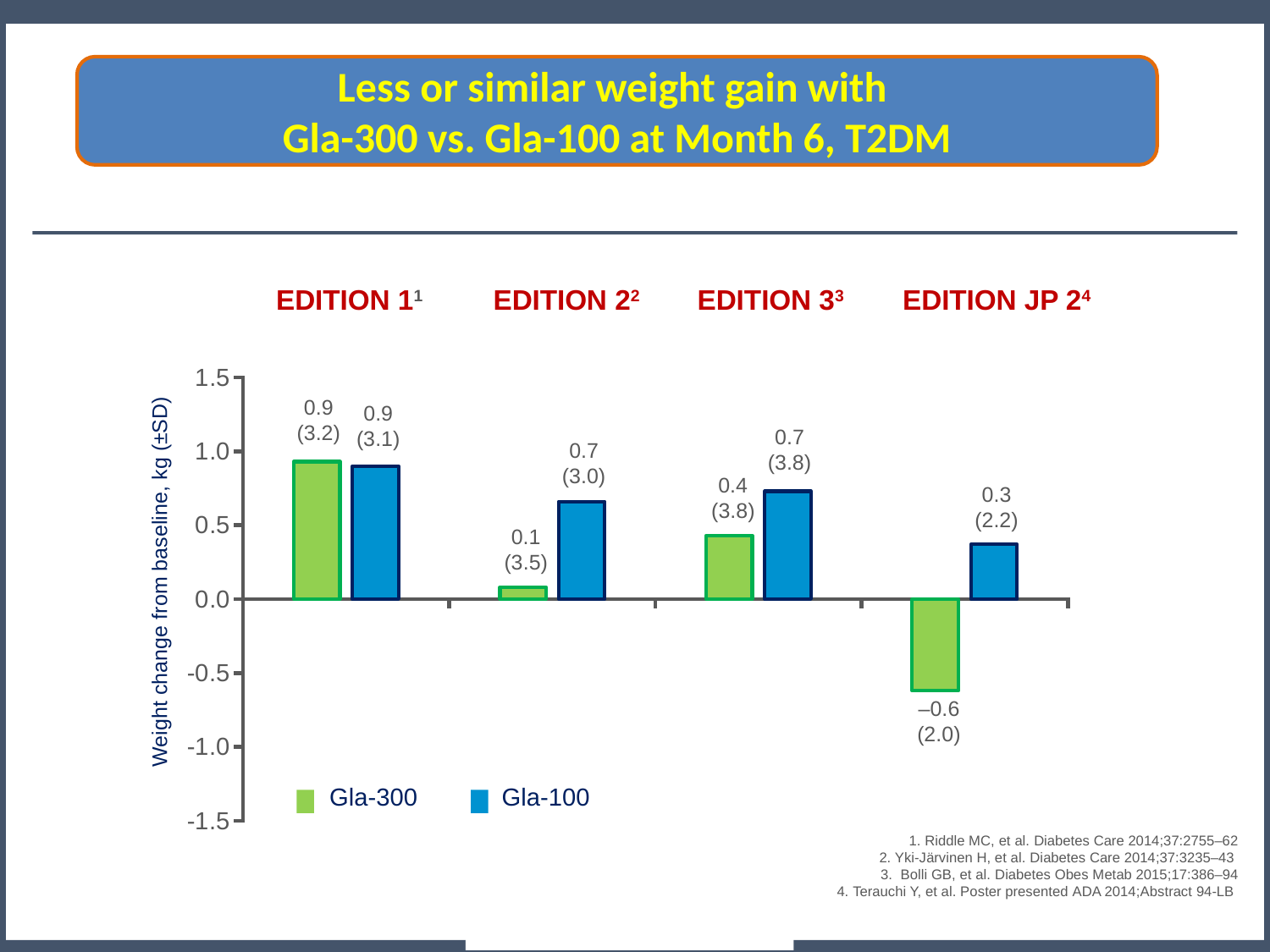
Is the Gla-300 value in EDITION 1 greater or less than 0.5? greater What is the difference between the Gla-100 and Gla-300 weight change in EDITION 2? 0.6 What is the weight change from baseline for Gla-300 in EDITION 2? 0.1 What is the weight change from baseline for Gla-100 in EDITION 3? 0.7 How many studies are shown on the x axis of the chart? 4 In EDITION 3, which has the larger weight change, Gla-300 or Gla-100? Gla-100 Which study shows the lowest weight change for Gla-300? EDITION JP 2 How many series does the legend list? 2 What is the weight change from baseline for Gla-300 in EDITION JP 2? –0.6 What type of chart is shown on the slide? Bar chart What is the SD shown in parentheses for Gla-100 in EDITION 1? 3.1 Which study shows the highest weight change for Gla-100? EDITION 1